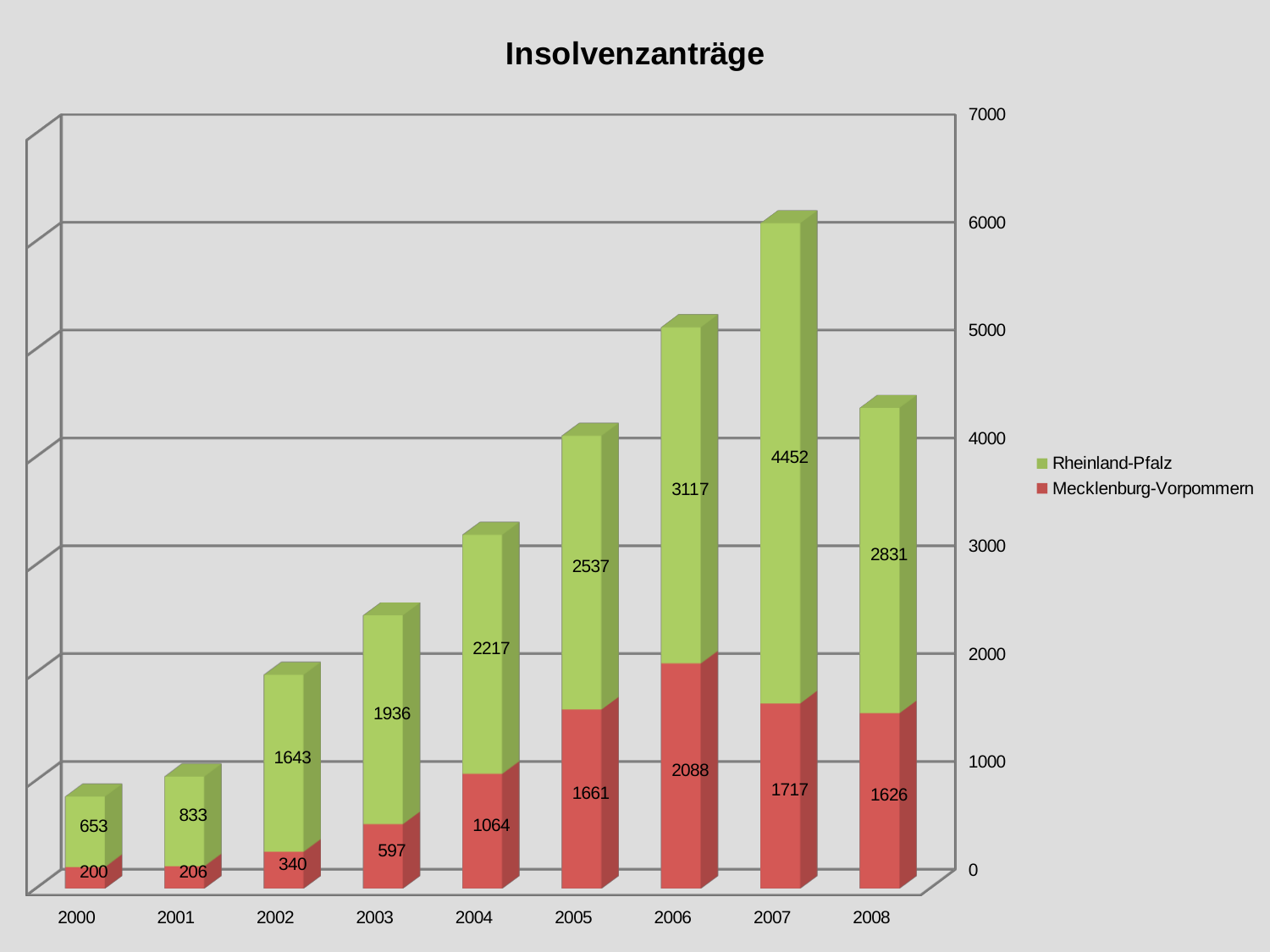
Which is larger: the Mecklenburg-Vorpommern value in 2006 or in 2007? 2006 What is the value for Mecklenburg-Vorpommern in 2004? 1064 What is the value for Rheinland-Pfalz in 2002? 1643 What is the total of the stacked bar for 2006? 5205 What is the value for Rheinland-Pfalz in 2007? 4452 How many series does the legend list? 2 In which year is the value for Rheinland-Pfalz highest? 2007 What kind of chart is shown? Stacked bar chart In which year is the value for Mecklenburg-Vorpommern lowest? 2000 What is the total of the stacked bar for 2000? 853 What is the difference between the Rheinland-Pfalz values for 2007 and 2008? 1621 How many years are shown on the x axis? 9